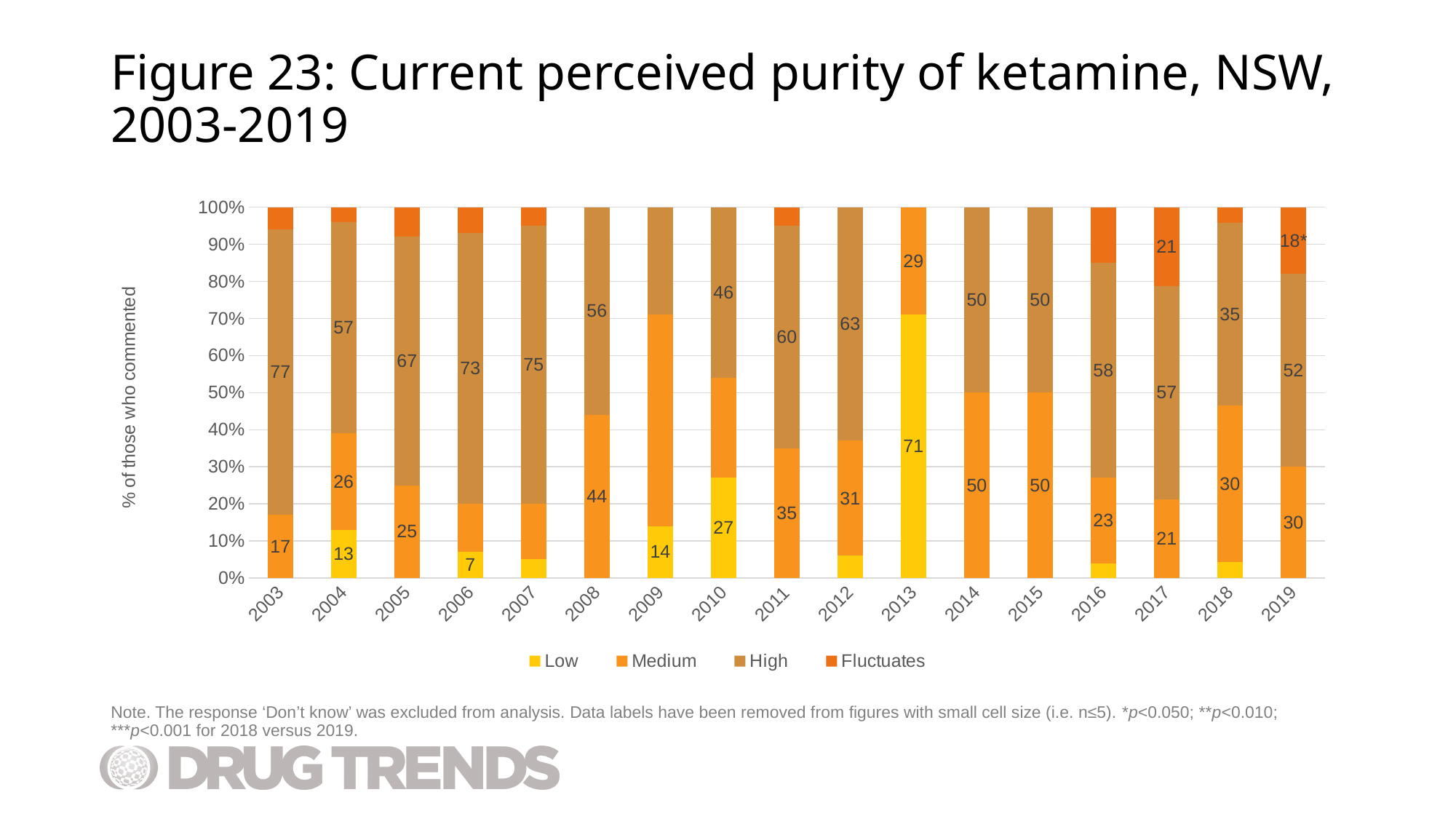
What is the label on the y axis? % of those who commented What is the value of the Fluctuates segment for 2017? 21 How many years are shown along the x axis? 17 In 2008, which is larger, the Medium segment or the High segment? High How many series does the legend list? 4 What kind of chart is shown on the slide? Stacked bar chart What is the value of the Low segment for 2013? 71 Which year has the highest labelled value for the High series? 2003 What is the value of the High segment for 2003? 77 What is the value of the Medium segment for 2005? 25 What is the difference between the High and Medium values in 2012? 32 Is the Low segment for 2013 greater or less than 50%? greater